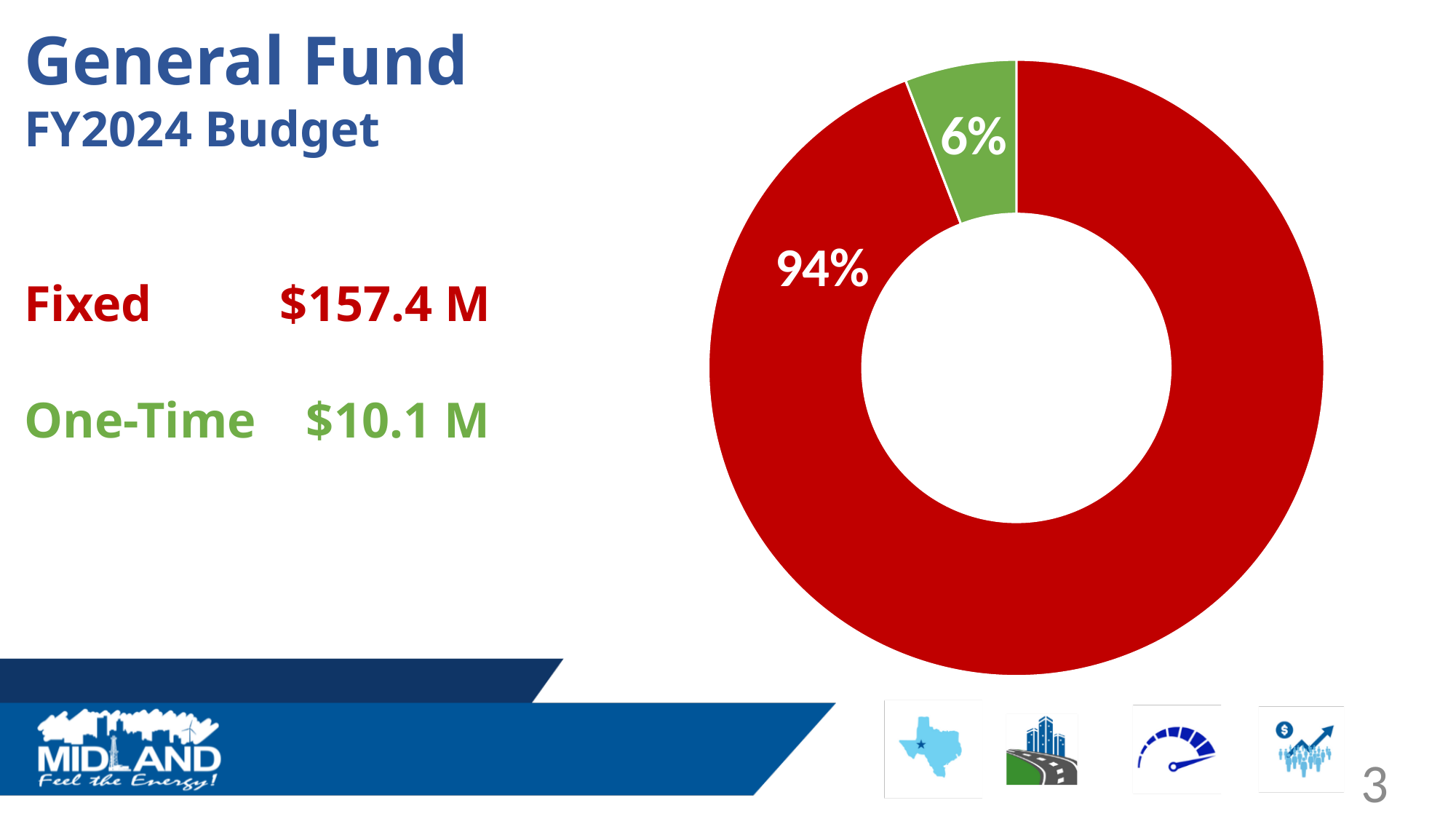
Which category has the largest slice in the General Fund FY2024 Budget chart? Fixed What is the difference in dollars between the Fixed and One-Time amounts? $147.3 M Which category has the smallest slice in the General Fund FY2024 Budget chart? One-Time What is the difference in percentage points between the Fixed and One-Time slices? 88 percentage points What colour is the One-Time slice in the chart? Green How many slices does the General Fund FY2024 Budget chart have? 2 What share of the General Fund FY2024 Budget donut chart is the Fixed (red) slice? 94% What kind of chart is shown on the slide? Donut (pie) chart What share of the General Fund FY2024 Budget donut chart is the One-Time (green) slice? 6% What is the dollar amount shown for Fixed in the General Fund FY2024 Budget? $157.4 M Which is larger in the General Fund FY2024 Budget, Fixed or One-Time? Fixed What is the dollar amount shown for One-Time in the General Fund FY2024 Budget? $10.1 M